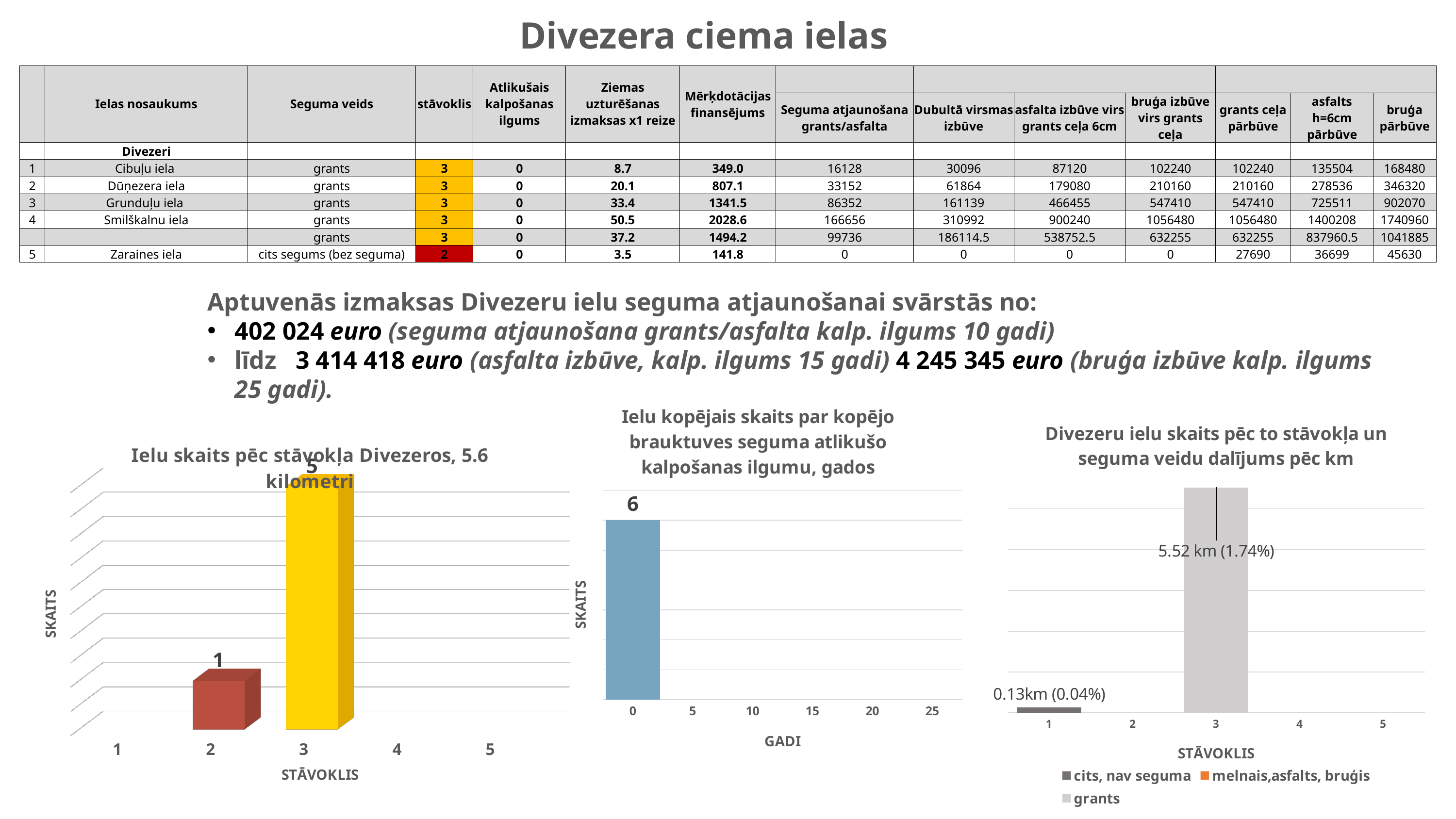
In the chart 'Ielu skaits pēc stāvokļa Divezeros, 5.6 kilometri', which condition category has the highest value? 3 In the middle chart 'Ielu kopējais skaits par kopējo brauktuves seguma atlikušo kalpošanas ilgumu, gados', how many tick categories are shown on the GADI axis? 6 In the chart 'Ielu skaits pēc stāvokļa Divezeros, 5.6 kilometri', what is the value for condition (stāvoklis) 3? 5 In the chart 'Ielu skaits pēc stāvokļa Divezeros, 5.6 kilometri', what is the value for condition (stāvoklis) 2? 1 In the chart 'Ielu skaits pēc stāvokļa Divezeros, 5.6 kilometri', what is the difference between the values for condition 3 and condition 2? 4 In the chart 'Ielu skaits pēc stāvokļa Divezeros, 5.6 kilometri', what is the label of the x axis? STĀVOKLIS In the chart 'Ielu skaits pēc stāvokļa Divezeros, 5.6 kilometri', what kind of chart is shown? Bar chart In the right chart 'Divezeru ielu skaits pēc to stāvokļa un seguma veidu dalījums pēc km', what is the data label on the bar for condition 3? 5.52 km (1.74%) In the middle chart 'Ielu kopējais skaits par kopējo brauktuves seguma atlikušo kalpošanas ilgumu, gados', what is the value for 0 years (gadi)? 6 In the right chart 'Divezeru ielu skaits pēc to stāvokļa un seguma veidu dalījums pēc km', which condition has the larger bar, 1 or 3? 3 In the right chart 'Divezeru ielu skaits pēc to stāvokļa un seguma veidu dalījums pēc km', how many series does the legend list? 3 In the right chart 'Divezeru ielu skaits pēc to stāvokļa un seguma veidu dalījums pēc km', what is the data label on the bar for condition 1? 0.13km (0.04%)